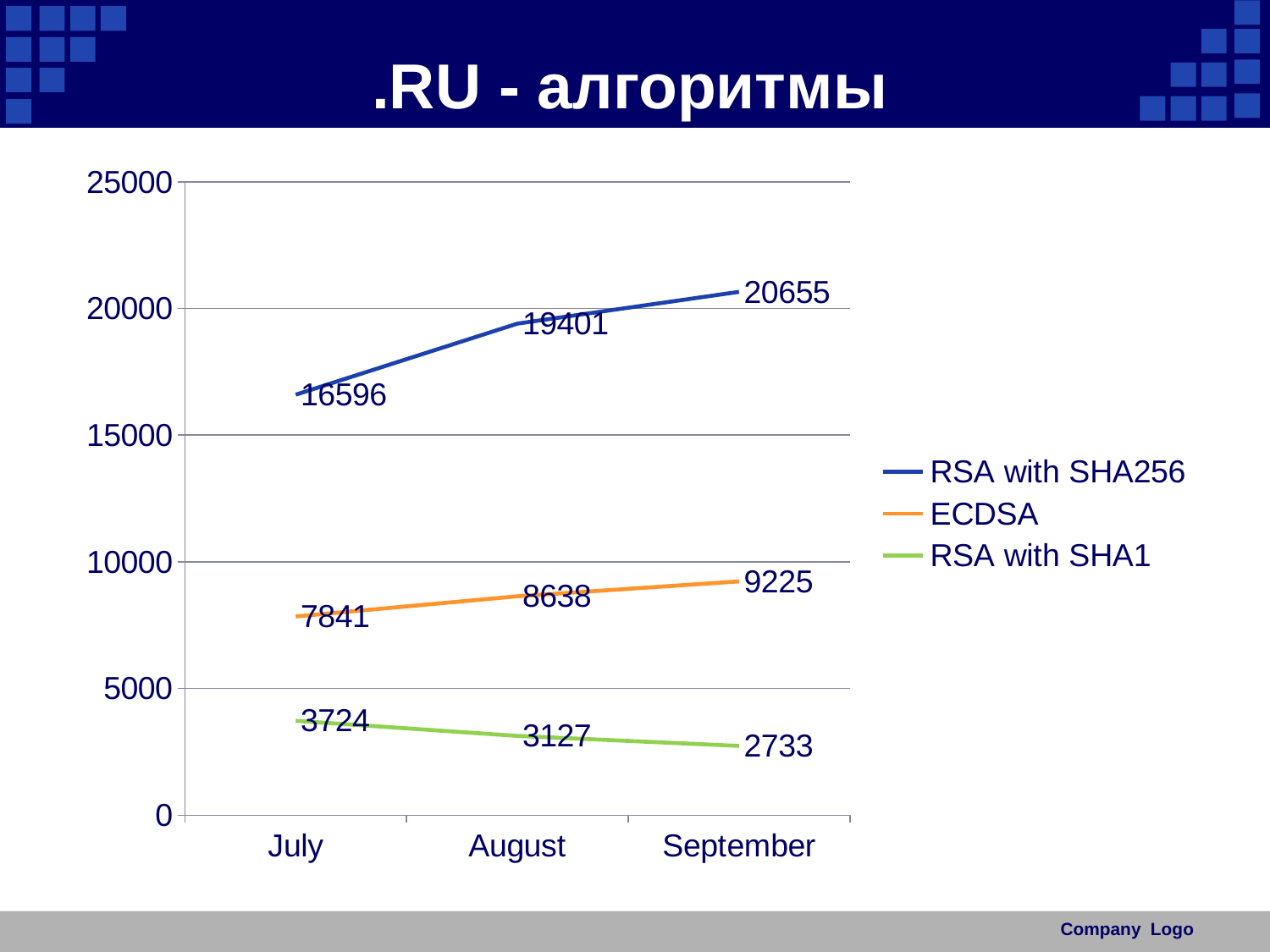
Is the value for ECDSA in July greater or less than 10000? less What kind of chart is shown on the slide? line chart What is the difference between the RSA with SHA256 values in September and July? 4059 What is the value for ECDSA in August? 8638 How many months are shown on the x axis? 3 Which is larger: the ECDSA value in September or the RSA with SHA1 value in September? ECDSA Which series has the lowest value in July? RSA with SHA1 How many series does the legend list? 3 What is the value for RSA with SHA256 in September? 20655 Do the values for RSA with SHA1 rise or fall from July to September? fall What is the value for RSA with SHA1 in July? 3724 Which series has the highest value in September? RSA with SHA256